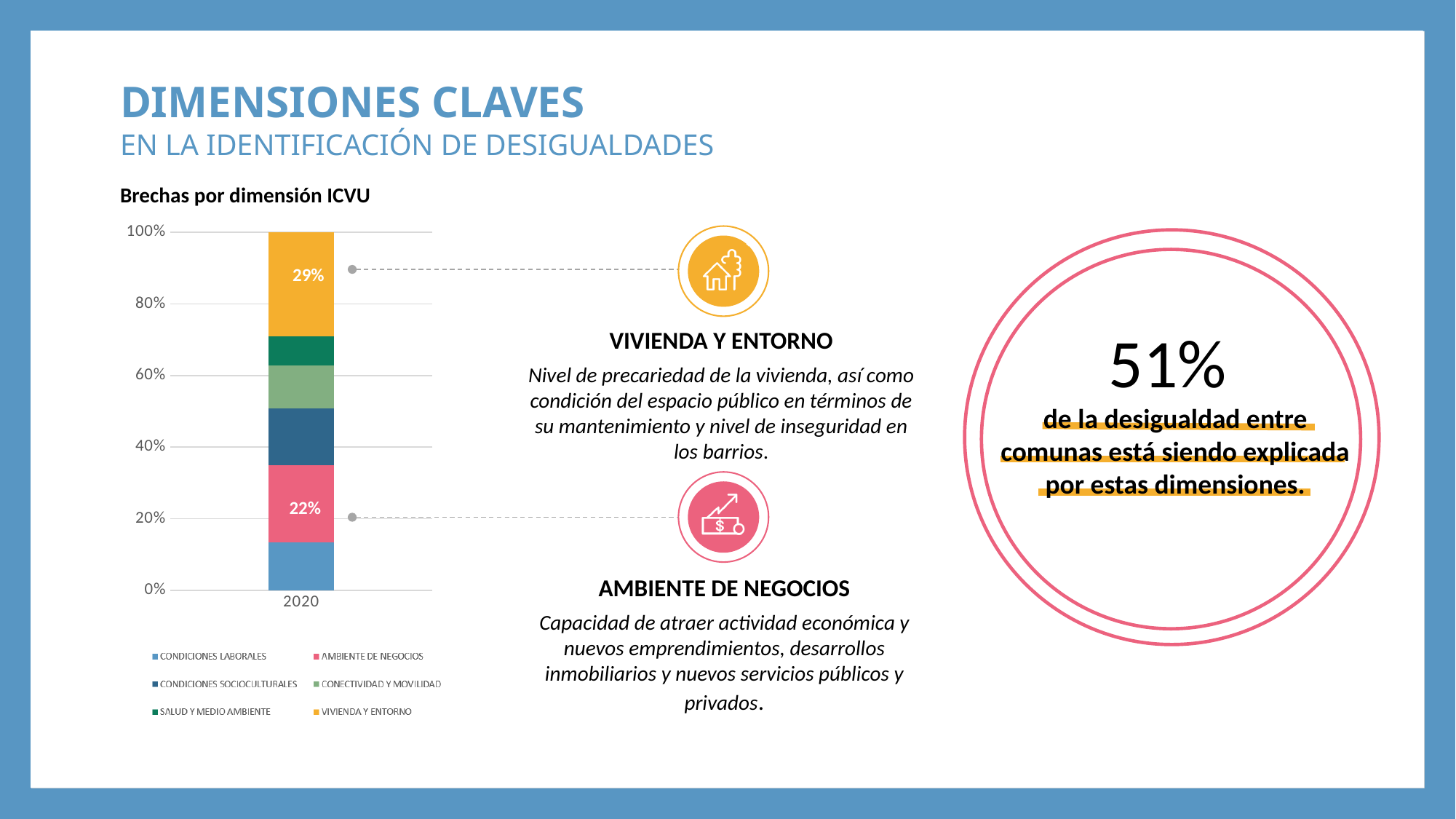
In the 'Brechas por dimensión ICVU' chart, what is the difference between the Vivienda y Entorno value and the Ambiente de Negocios value? 7% In the 'Brechas por dimensión ICVU' chart, is the value for Condiciones Laborales greater or less than 20%? less In the 'Brechas por dimensión ICVU' chart, what is the value shown for Vivienda y Entorno? 29% What is the x-axis category label of the stacked bar in the 'Brechas por dimensión ICVU' chart? 2020 How many categories are shown on the x axis of the 'Brechas por dimensión ICVU' chart? 1 How many series does the legend of the 'Brechas por dimensión ICVU' chart list? 6 What is the total height of the stacked bar for 2020 in the 'Brechas por dimensión ICVU' chart? 100% In the 'Brechas por dimensión ICVU' chart, what is the value shown for Ambiente de Negocios? 22% What kind of chart is 'Brechas por dimensión ICVU'? Stacked bar chart In the 'Brechas por dimensión ICVU' chart, which series has the largest segment in the stacked bar? Vivienda y Entorno In the 'Brechas por dimensión ICVU' chart, is the value for Salud y Medio Ambiente greater or less than 20%? less In the 'Brechas por dimensión ICVU' chart, which is larger: Vivienda y Entorno or Ambiente de Negocios? Vivienda y Entorno